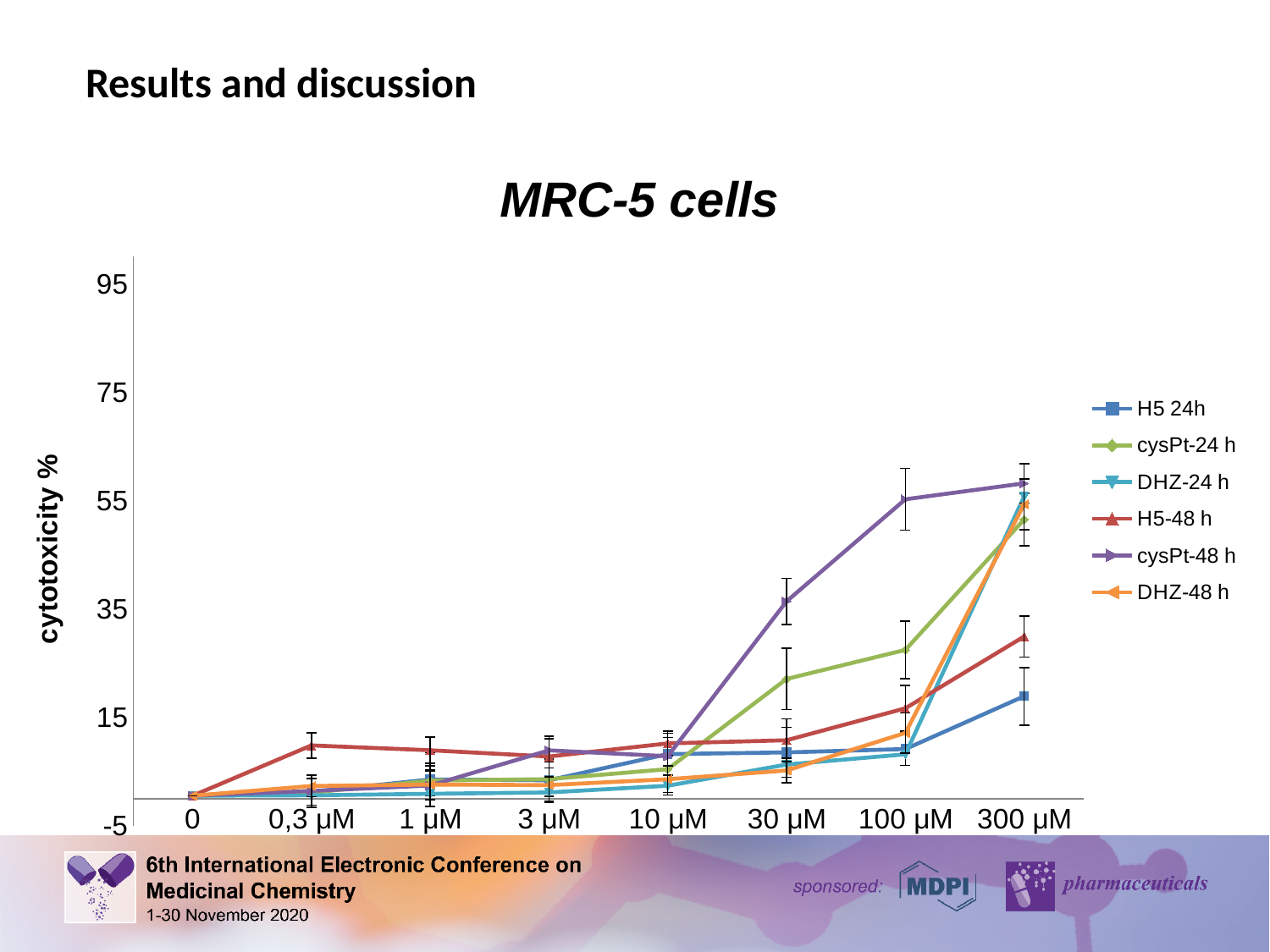
What is the title of the chart? MRC-5 cells What is the label of the y axis? cytotoxicity % How many concentration categories are shown on the x axis? 8 Which series has the lowest cytotoxicity at 300 µM? H5 24h Does the cytotoxicity for cysPt-48 h generally rise or fall as concentration increases along the x axis? rise Is the value for cysPt-48 h at 30 µM greater or less than 15? greater What kind of chart is shown on the slide? line chart How many series does the legend list? 6 Is the value for H5-48 h at 300 µM greater or less than 35? less Which series has the highest cytotoxicity at 100 µM? cysPt-48 h Is the value for cysPt-24 h at 300 µM greater or less than 35? greater At 30 µM, which is larger: the value for cysPt-48 h or the value for cysPt-24 h? cysPt-48 h